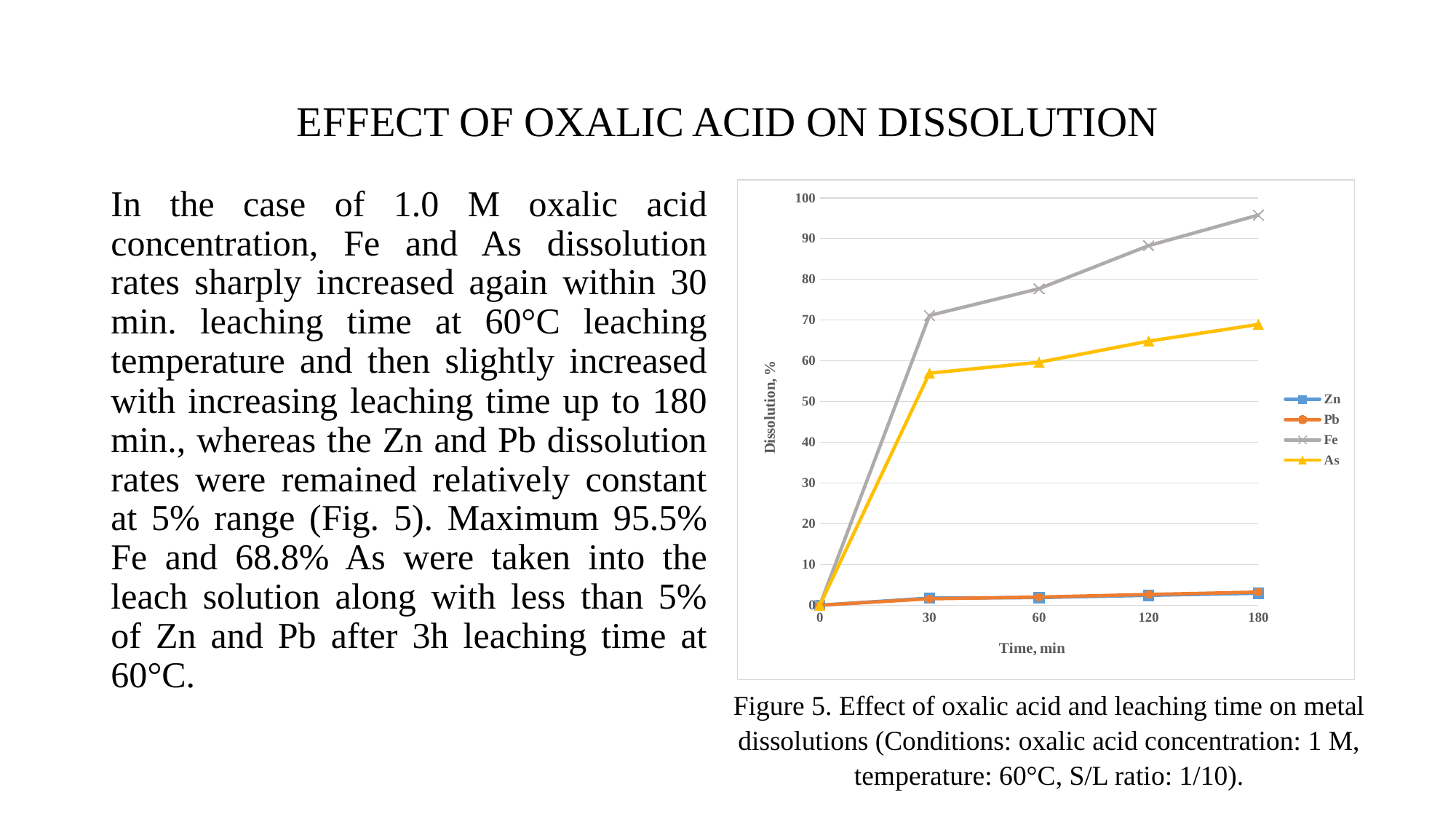
Is the Zn dissolution at 180 min greater or less than 10? less Which is larger at 120 min, the Fe dissolution or the As dissolution? Fe Which series has the highest dissolution at 180 min? Fe How many time points are plotted along the x axis of the chart? 5 How many series does the chart legend list? 4 Is the As dissolution at 30 min greater or less than 50? greater What kind of chart is shown on the slide? line chart What is the label of the y axis of the chart? Dissolution, % Does the Fe dissolution rise or fall as time increases from 0 to 180 min? rise Is the Fe dissolution at 30 min greater or less than 60? greater What is the label of the x axis of the chart? Time, min